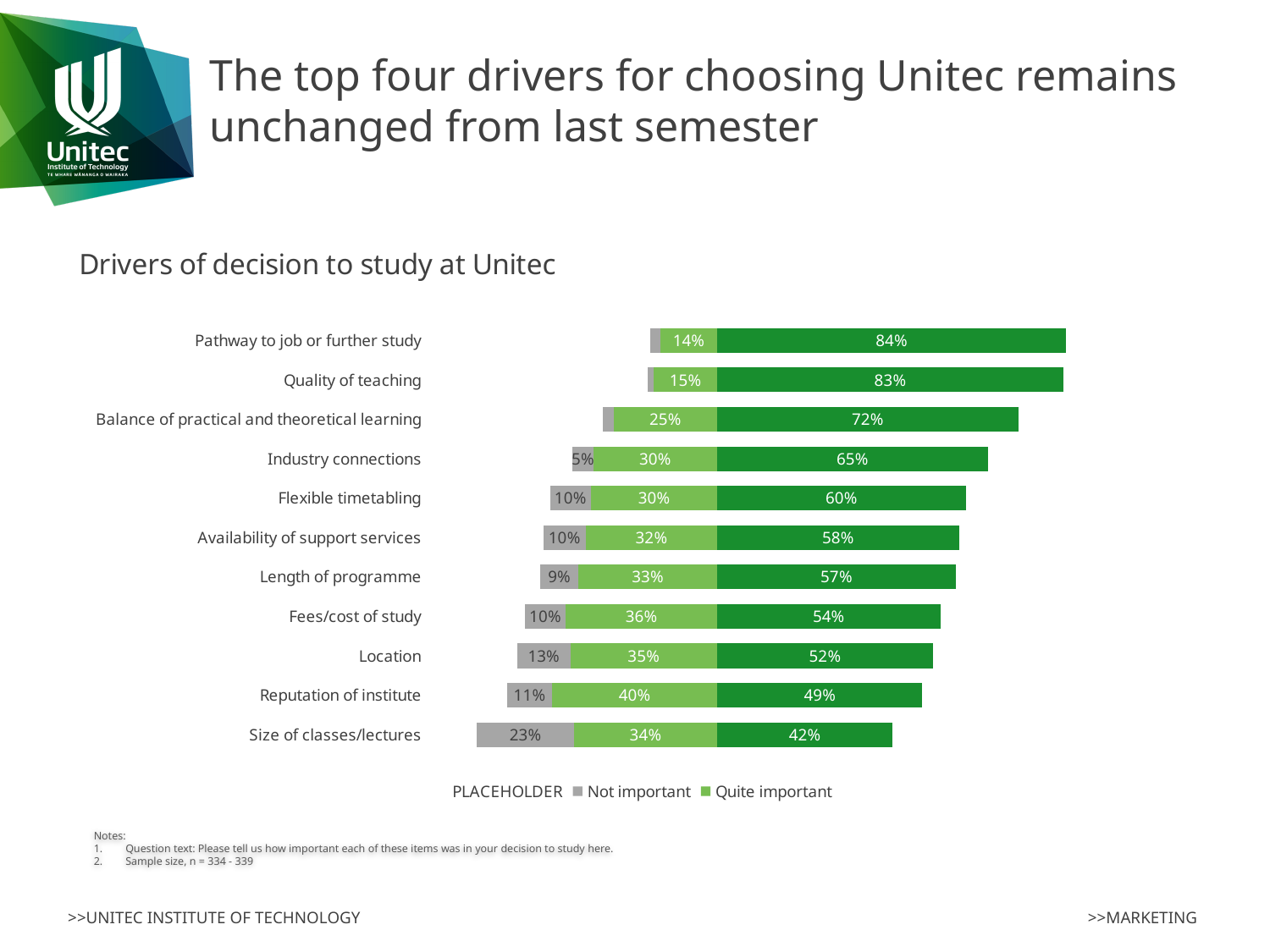
What kind of chart is shown on the slide? Stacked bar chart What is the title of the chart? Drivers of decision to study at Unitec What is the value of the dark green (rightmost) segment for "Pathway to job or further study"? 84% Which has the larger dark green segment value: "Flexible timetabling" or "Fees/cost of study"? Flexible timetabling What is the difference between the dark green segment values for "Pathway to job or further study" and "Size of classes/lectures"? 42 percentage points Which category has the lowest value in the dark green (rightmost) segment? Size of classes/lectures How many categories are shown on the chart? 11 What is the value of the light green (middle) segment for "Reputation of institute"? 40% How many entries does the legend list? 3 What is the total of the three labelled segments for "Length of programme"? 99% What is the value of the grey (leftmost) segment for "Size of classes/lectures"? 23% Which category has the highest value in the dark green (rightmost) segment? Pathway to job or further study